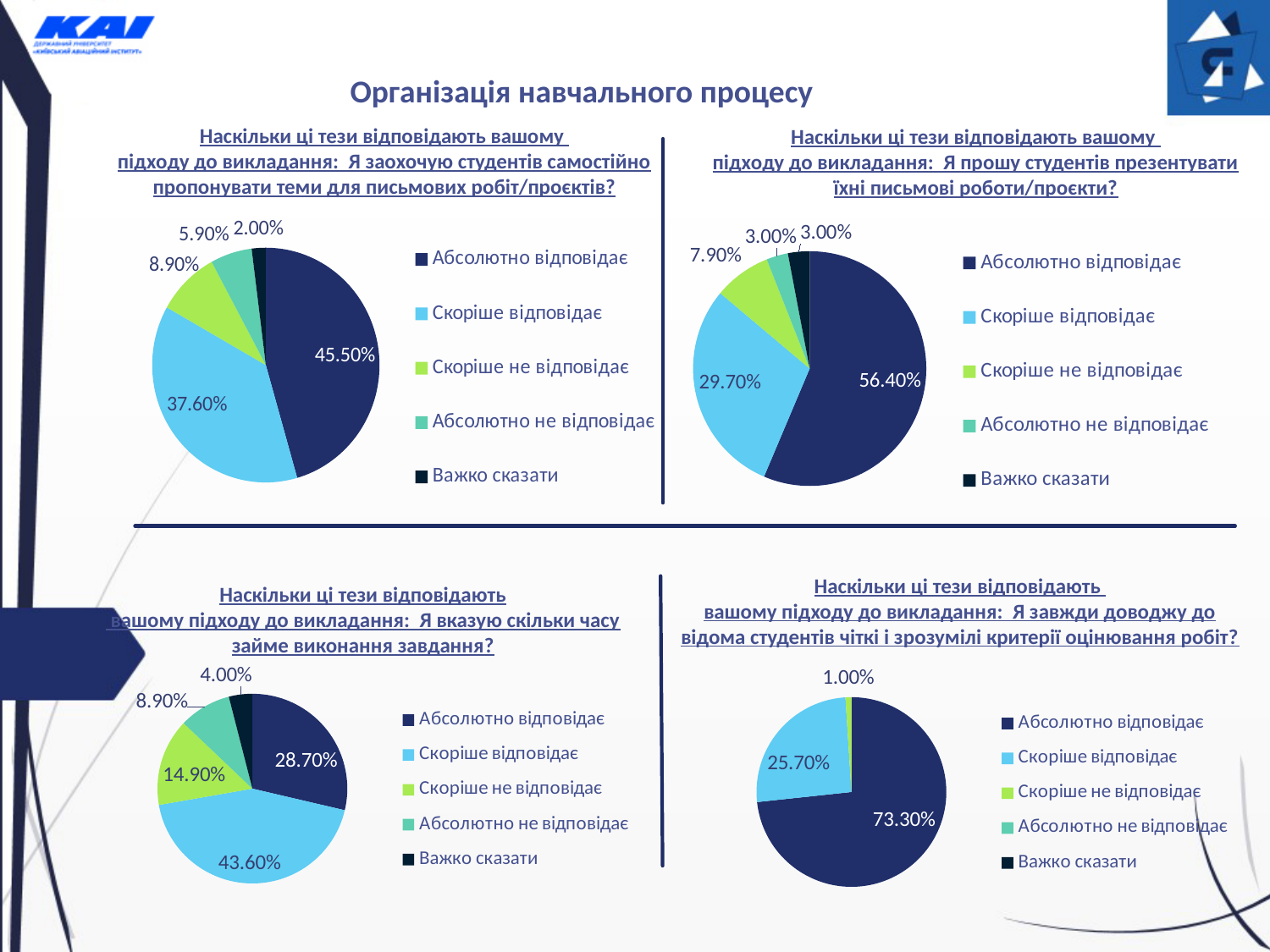
In the top-left pie chart, what share of respondents chose "Скоріше відповідає"? 37.60% In the bottom-right pie chart, what share of respondents chose "Абсолютно відповідає"? 73.30% In the bottom-left pie chart, what share of respondents chose "Скоріше не відповідає"? 14.90% In the top-left pie chart, what share of respondents chose "Абсолютно відповідає"? 45.50% What type of chart is used in the bottom-left panel of the slide? Pie chart In the bottom-right pie chart, what is the difference between the "Абсолютно відповідає" and "Скоріше відповідає" shares? 47.60% In the top-left pie chart, which category has the smallest share? Важко сказати In the top-right pie chart, what share of respondents chose "Абсолютно відповідає"? 56.40% In the top-left pie chart, which is larger: the share for "Скоріше не відповідає" or for "Абсолютно не відповідає"? Скоріше не відповідає In the top-right pie chart, what share of respondents chose "Скоріше не відповідає"? 7.90% In the bottom-left pie chart, which category has the largest share? Скоріше відповідає How many entries does the legend of the top-right chart list? 5